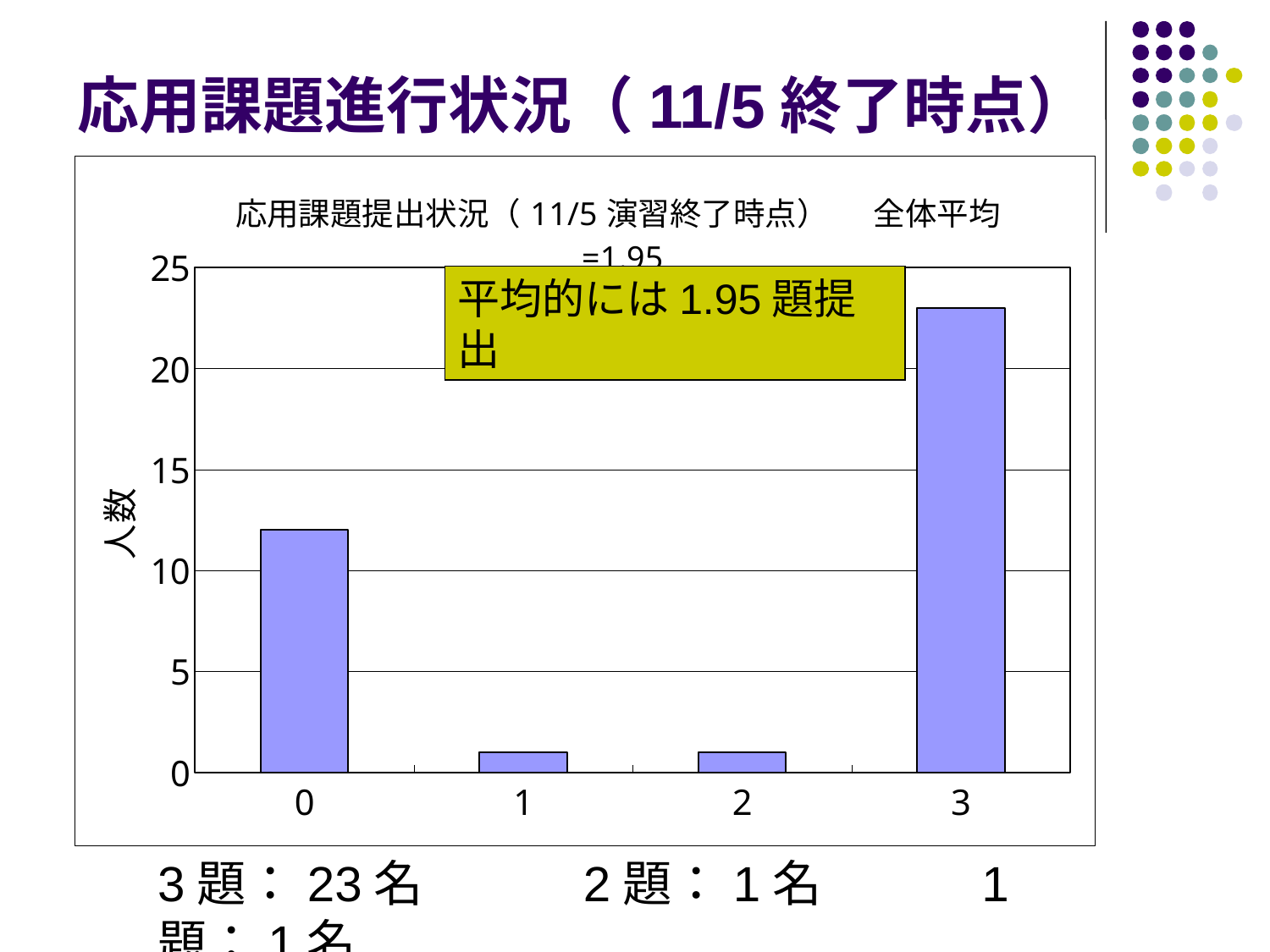
Which category has the highest value in the chart? 3 What is the value (人数) for category 1? 1 Which is larger, the value for category 0 or the value for category 3? 3 What is the value (人数) for category 2? 1 How many categories are shown on the x axis of the chart? 4 Is the value for category 0 greater or less than 10? greater What is the label of the y axis of the chart? 人数 Is the value for category 0 greater or less than 15? less What kind of chart is shown on the slide? bar chart What is the value (人数) for category 3? 23 Is the value for category 3 greater or less than 20? greater What is the difference between the values for category 3 and category 2? 22